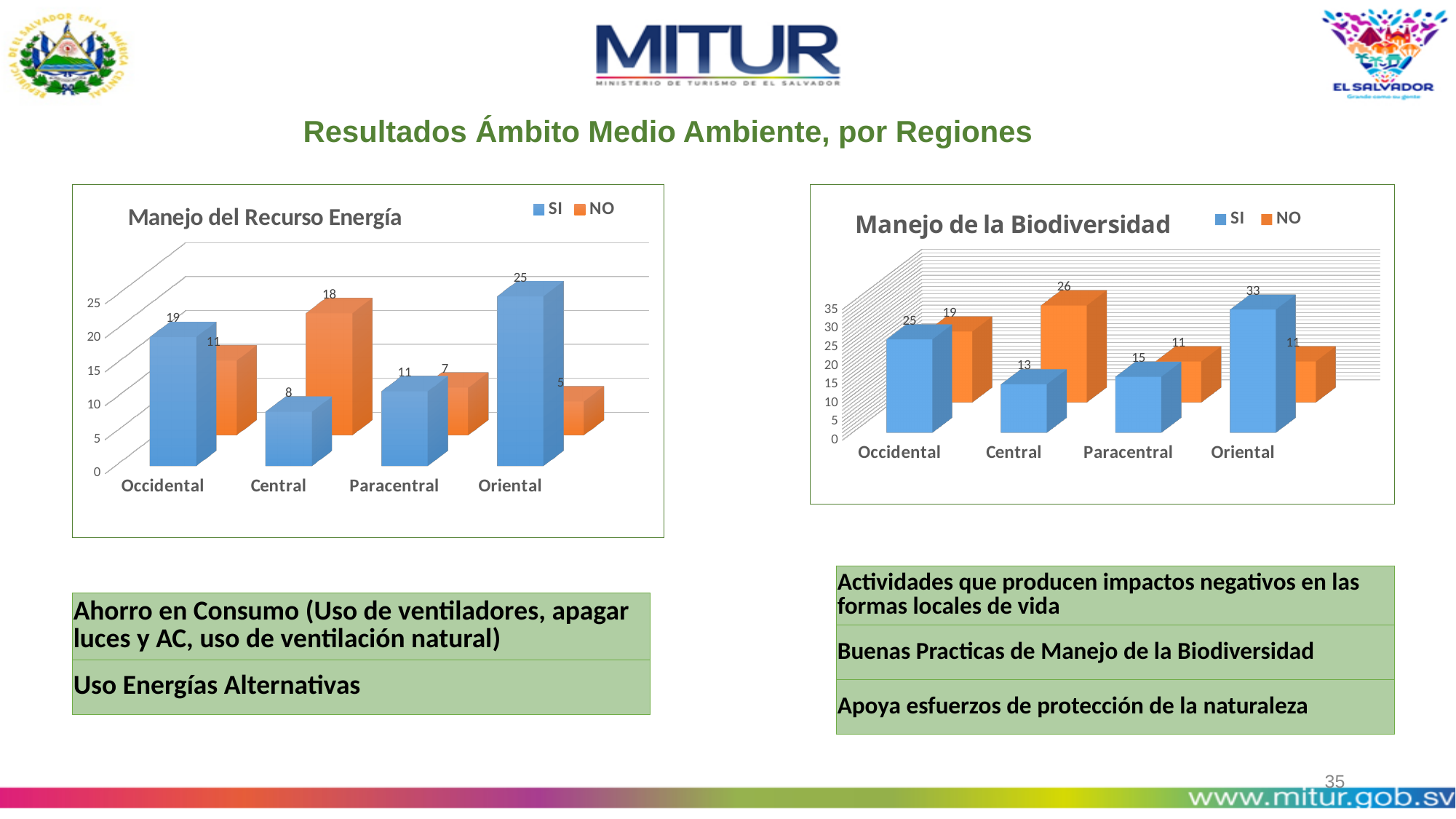
In the 'Manejo de la Biodiversidad' chart, what is the difference between the SI and NO values for Occidental? 6 In the 'Manejo del Recurso Energía' chart, which is larger for Paracentral, SI or NO? SI In the 'Manejo de la Biodiversidad' chart, what is the NO value for Central? 26 How many series does the legend of the 'Manejo del Recurso Energía' chart list? 2 How many regions are shown on the x axis of the 'Manejo de la Biodiversidad' chart? 4 In the 'Manejo del Recurso Energía' chart, what is the SI value for Oriental? 25 In the 'Manejo de la Biodiversidad' chart, which region has the highest NO value? Central What type of chart is the 'Manejo de la Biodiversidad' chart? Bar chart In the 'Manejo del Recurso Energía' chart, what is the difference between the SI and NO values for Occidental? 8 In the 'Manejo del Recurso Energía' chart, what is the NO value for Central? 18 In the 'Manejo de la Biodiversidad' chart, what is the SI value for Oriental? 33 In the 'Manejo del Recurso Energía' chart, which region has the lowest SI value? Central